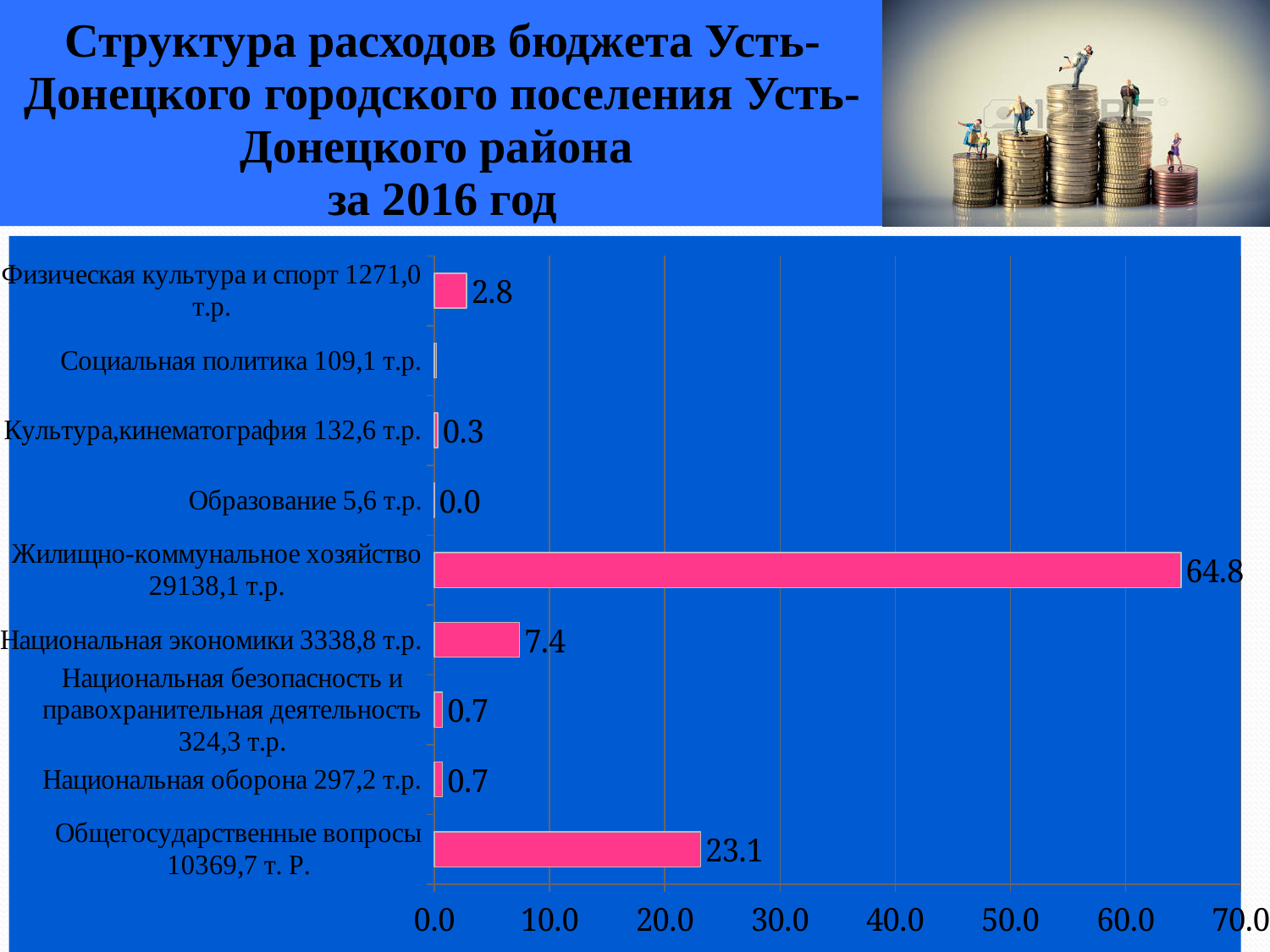
What is the value shown for Образование? 0.0 How many categories are shown on the chart? 9 Is the value for Жилищно-коммунальное хозяйство greater or less than 60.0? greater Which is larger, the value for Национальная экономики or the value for Физическая культура и спорт? Национальная экономики What is the difference between the values for Жилищно-коммунальное хозяйство and Общегосударственные вопросы? 41.7 What type of chart is shown on the slide? bar chart What is the value shown for Общегосударственные вопросы? 23.1 What is the maximum value shown on the horizontal axis? 70.0 Which category has the highest value? Жилищно-коммунальное хозяйство What is the value shown for Физическая культура и спорт? 2.8 What is the value shown for Жилищно-коммунальное хозяйство? 64.8 What is the value shown for Национальная экономики? 7.4